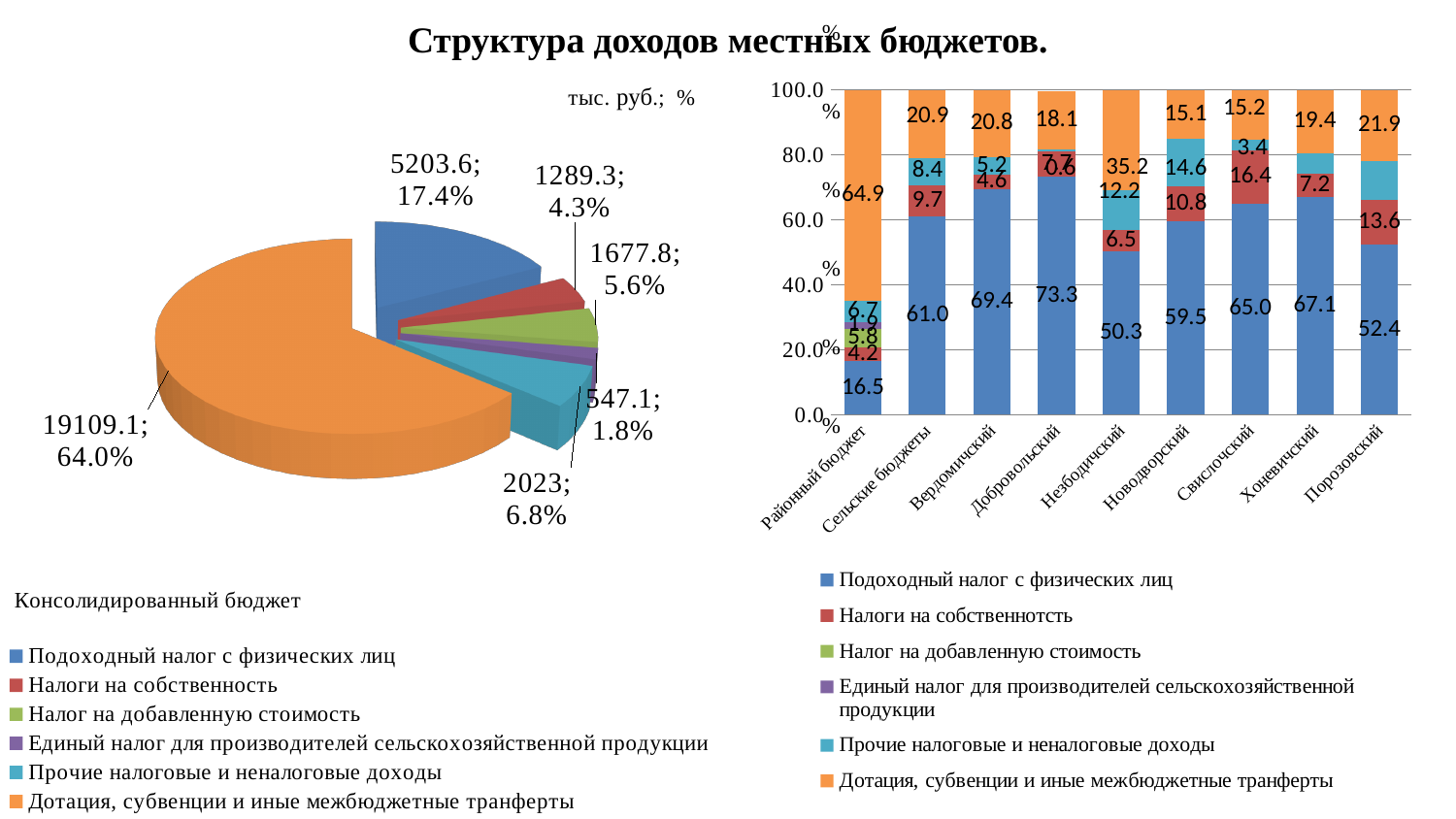
In the right bar chart, which category has the highest value for Подоходный налог с физических лиц? Добровольский In the pie chart (Консолидированный бюджет), which category has the smallest slice? Единый налог для производителей сельскохозяйственной продукции In the pie chart (Консолидированный бюджет), what is the value (тыс. руб.) for Подоходный налог с физических лиц? 5203.6 In the right bar chart, how many budget categories are shown on the x axis? 9 What kind of chart is the left chart (Консолидированный бюджет)? Pie chart In the right bar chart, which category has the lowest value for Подоходный налог с физических лиц? Районный бюджет In the pie chart (Консолидированный бюджет), what share does Дотация, субвенции и иные межбюджетные трансферты have? 64.0% What kind of chart is the right chart on the slide? Stacked bar chart In the right bar chart, how many series does the legend list? 6 In the right bar chart, what is the value of Дотация, субвенции и иные межбюджетные трансферты for Районный бюджет? 64.9 In the right bar chart, what is the value of Подоходный налог с физических лиц for Добровольский? 73.3 In the right bar chart, what is the difference in Подоходный налог с физических лиц between Вердомичский and Сельские бюджеты? 8.4